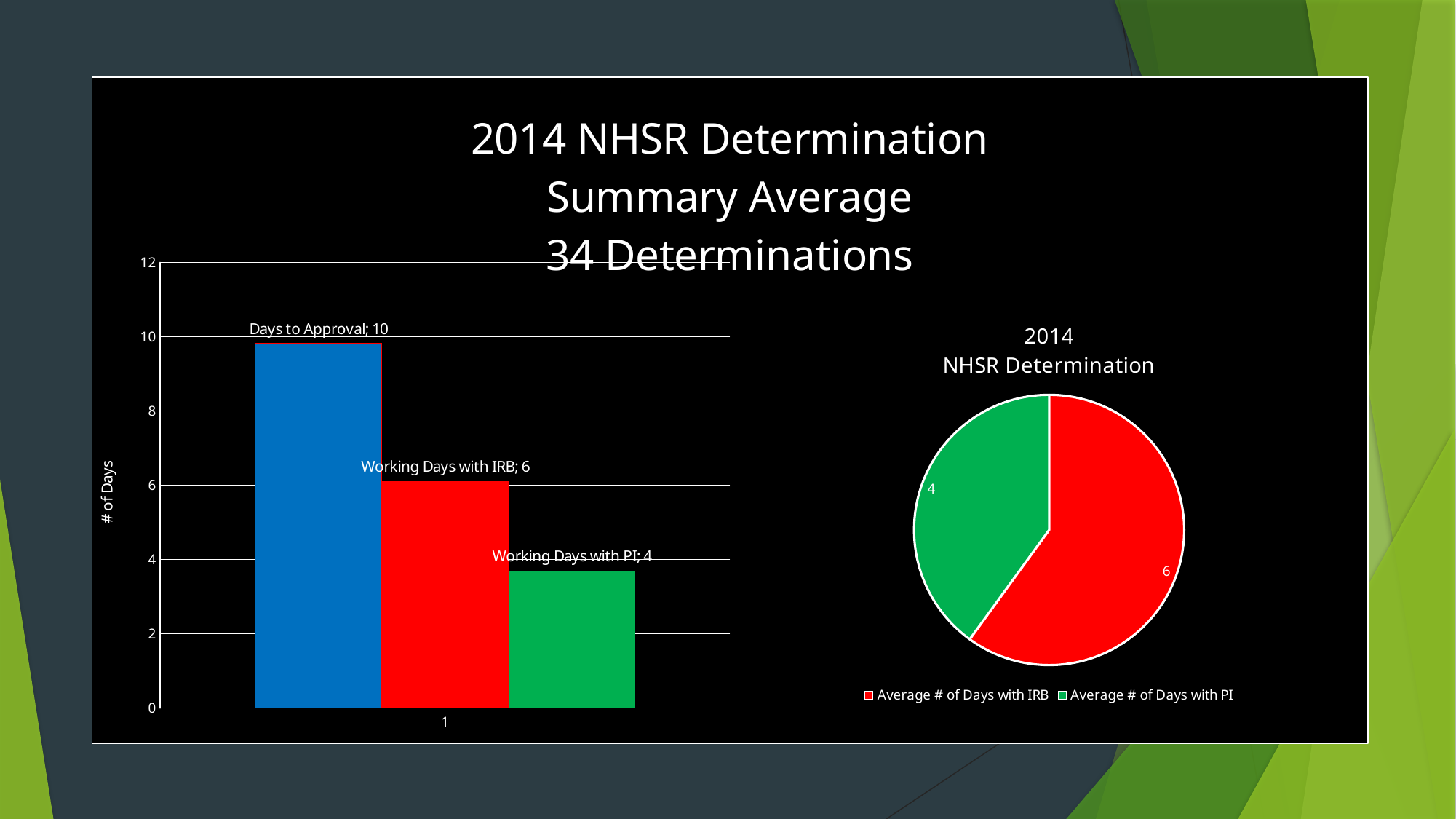
In the bar chart on the left, what is the value for Working Days with IRB? 6 In the bar chart on the left, which series has the highest value? Days to Approval In the bar chart on the left, which is larger: Working Days with IRB or Working Days with PI? Working Days with IRB In the bar chart on the left, what is the difference between Days to Approval and Working Days with PI? 6 In the pie chart titled '2014 NHSR Determination', what is the value for Average # of Days with IRB? 6 In the bar chart on the left, what is the label of the vertical axis? # of Days How many entries does the legend of the pie chart titled '2014 NHSR Determination' list? 2 In the bar chart on the left, what is the value for Working Days with PI? 4 In the pie chart titled '2014 NHSR Determination', what share of the pie does Average # of Days with PI represent? 40% In the bar chart on the left, what is the value for Days to Approval? 10 In the bar chart on the left, which series has the lowest value? Working Days with PI What kind of chart is the chart on the left of the slide? bar chart